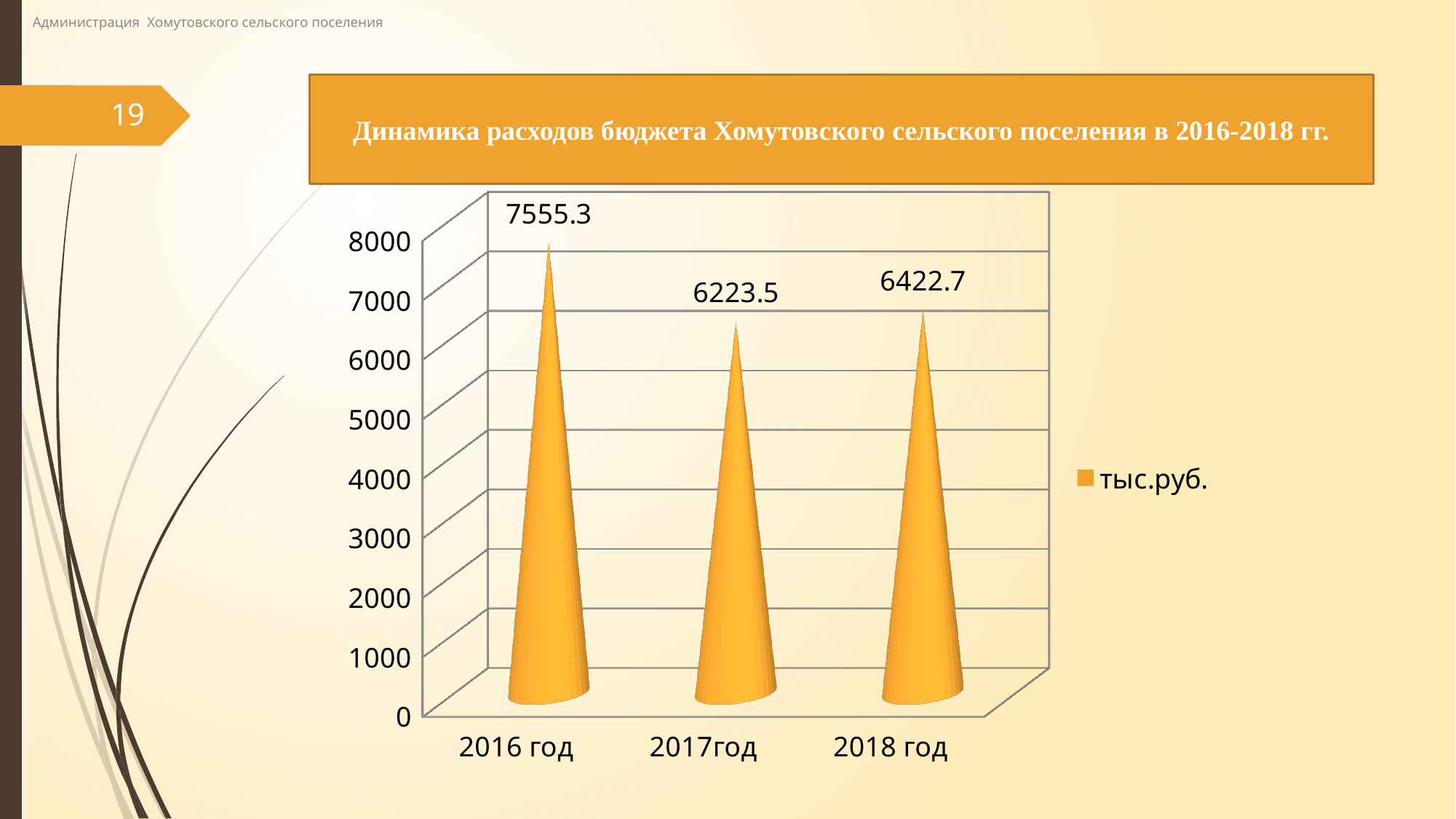
Is the value for 2017год greater or less than 7000? less What is the difference between the values for 2018 год and 2017год? 199.2 Which year has the lowest value? 2017год What is the difference between the values for 2016 год and 2017год? 1331.8 How many categories are shown on the x axis? 3 What is the legend entry of the chart? тыс.руб. Which year has the highest value? 2016 год What is the value for 2017год? 6223.5 What is the value for 2016 год? 7555.3 What kind of chart is shown on the slide? bar chart What is the value for 2018 год? 6422.7 Which is larger, the value for 2016 год or the value for 2018 год? 2016 год